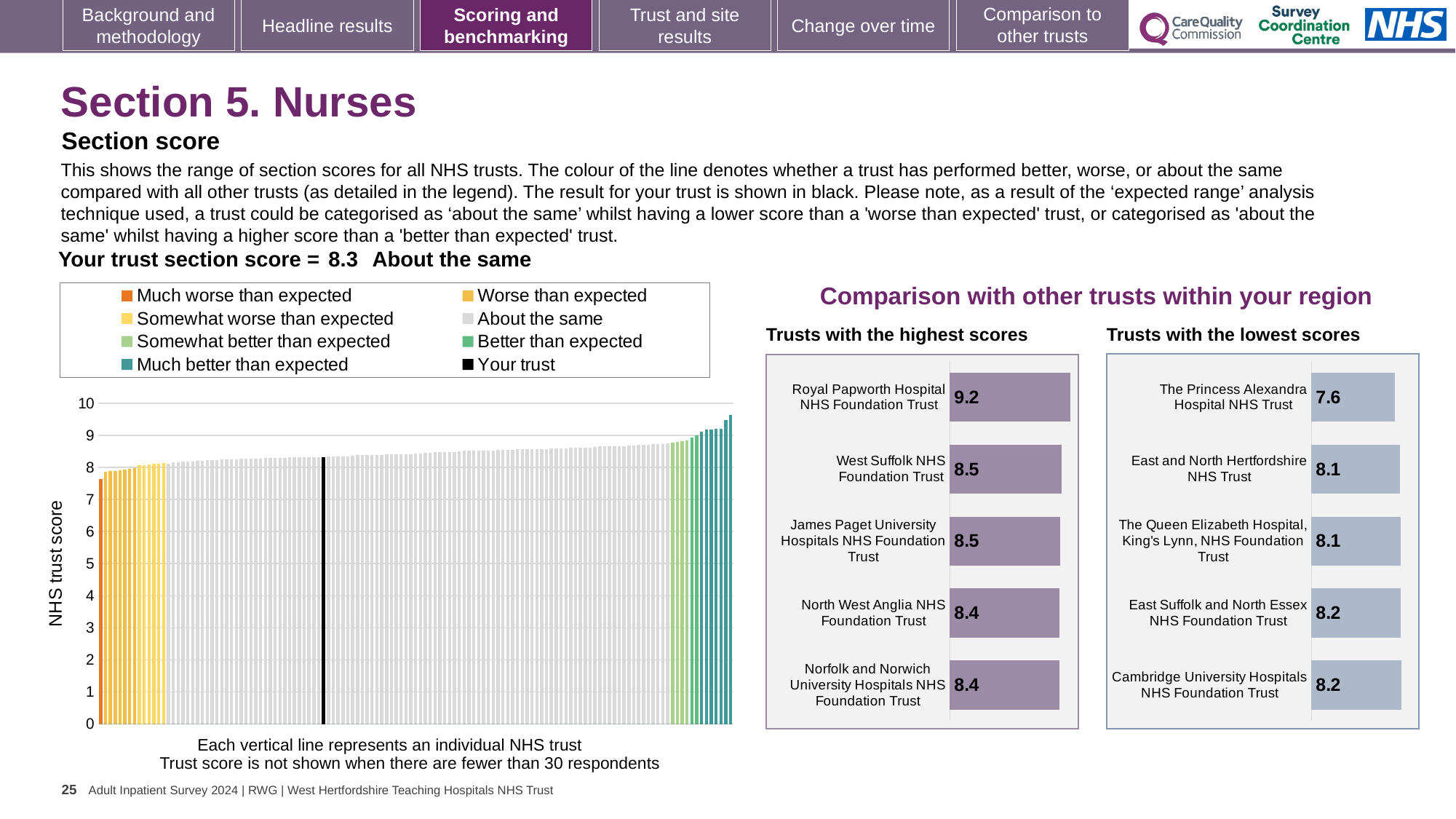
What is the section score for your trust shown in black on the main 'NHS trust score' chart? 8.3 In the 'Trusts with the highest scores' chart, which trust has the highest score? Royal Papworth Hospital NHS Foundation Trust In the 'Trusts with the highest scores' chart, what is the difference between the scores of Royal Papworth Hospital NHS Foundation Trust and West Suffolk NHS Foundation Trust? 0.7 How many trusts are shown in the 'Trusts with the highest scores' chart? 5 In the 'Trusts with the lowest scores' chart, what is the difference between the scores of Cambridge University Hospitals NHS Foundation Trust and The Princess Alexandra Hospital NHS Trust? 0.6 How many entries does the legend of the main 'NHS trust score' chart list? 8 What kind of chart is the main 'NHS trust score' chart on the left of the slide? Bar chart In the main 'NHS trust score' chart, do the values rise or fall from left to right along the x axis? Rise In the 'Trusts with the lowest scores' chart, which has the larger score: East and North Hertfordshire NHS Trust or Cambridge University Hospitals NHS Foundation Trust? Cambridge University Hospitals NHS Foundation Trust In the 'Trusts with the highest scores' chart, what is the score for Royal Papworth Hospital NHS Foundation Trust? 9.2 In the 'Trusts with the lowest scores' chart, what is the score for The Princess Alexandra Hospital NHS Trust? 7.6 In the 'Trusts with the lowest scores' chart, which trust has the lowest score? The Princess Alexandra Hospital NHS Trust